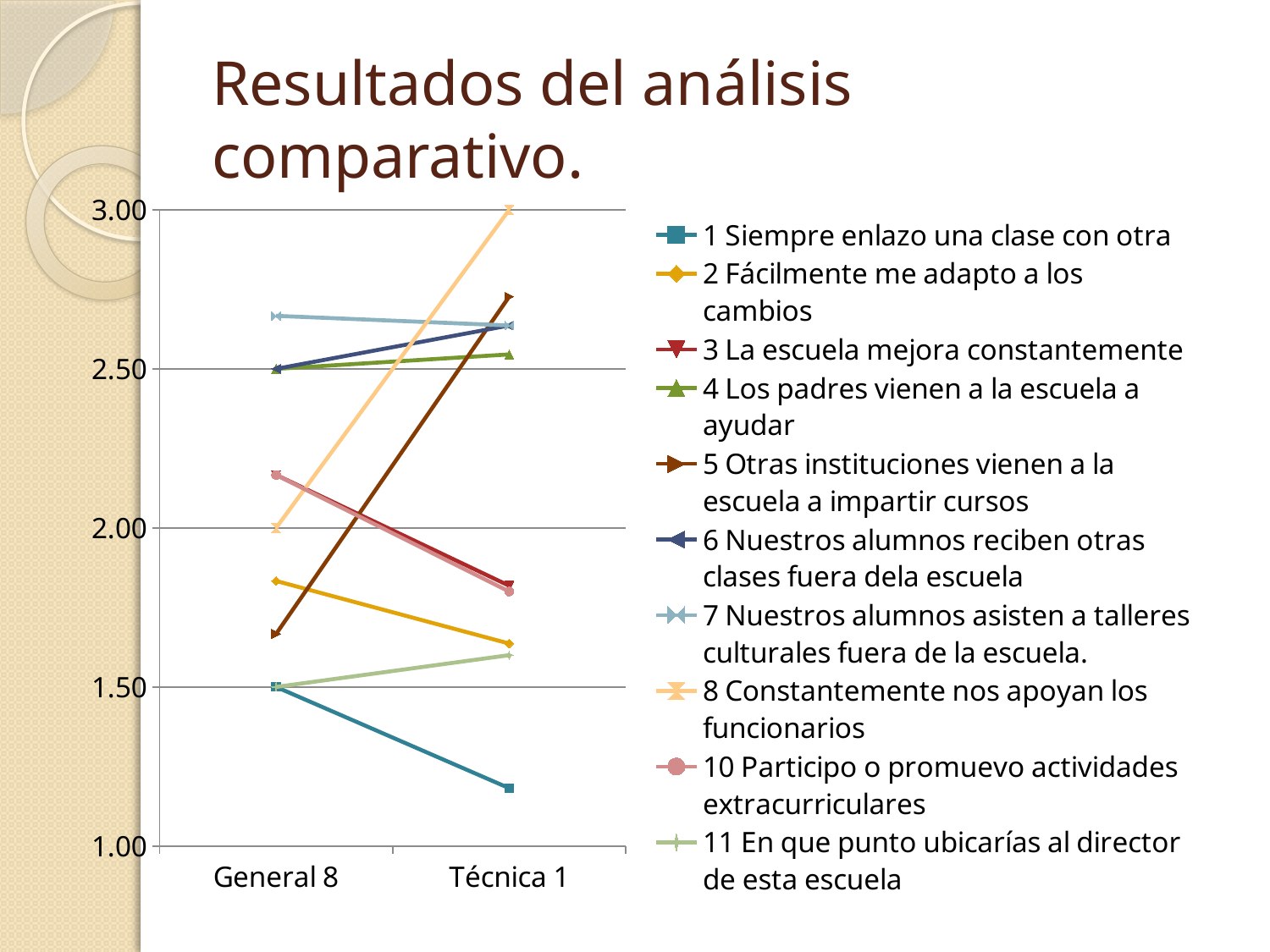
How many series does the legend list? 10 How many categories are shown on the x axis? 2 Does the line for series 2 (Fácilmente me adapto a los cambios) rise or fall from General 8 to Técnica 1? fall What is the value for series 1 (Siempre enlazo una clase con otra) at General 8? 1.50 Is the value for series 3 (La escuela mejora constantemente) at General 8 greater or less than 2.00? greater What is the value for series 8 (Constantemente nos apoyan los funcionarios) at General 8? 2.00 What is the value for series 8 (Constantemente nos apoyan los funcionarios) at Técnica 1? 3.00 Which series has the highest value at Técnica 1? 8 Constantemente nos apoyan los funcionarios What kind of chart is shown on the slide? line chart Does the line for series 5 (Otras instituciones vienen a la escuela a impartir cursos) rise or fall from General 8 to Técnica 1? rise Which series has the lowest value at Técnica 1? 1 Siempre enlazo una clase con otra Is the value for series 1 (Siempre enlazo una clase con otra) at Técnica 1 greater or less than 1.50? less